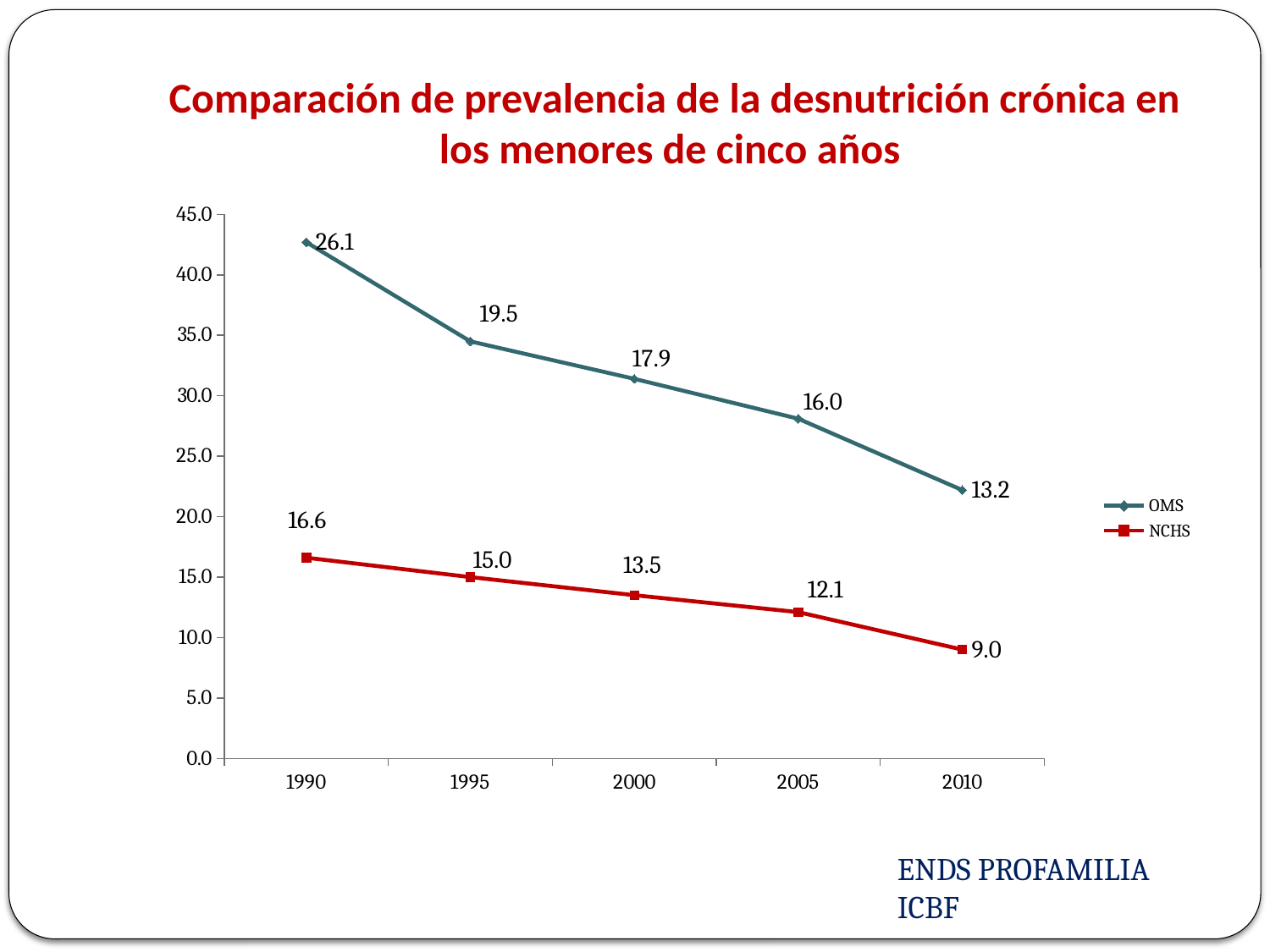
What is the NCHS value for 2000? 13.5 How many series does the legend list? 2 What is the difference between the OMS and NCHS values in 1995? 4.5 How many years are shown on the x axis? 5 In which year is the NCHS series lowest? 2010 Do the OMS values rise or fall from 1990 to 2010? Fall What kind of chart is shown on the slide? Line chart Which series has the larger value in 2010, OMS or NCHS? OMS What is the NCHS value for 2010? 9.0 What is the OMS value for 1990? 26.1 In which year is the OMS series highest? 1990 What is the OMS value for 2005? 16.0